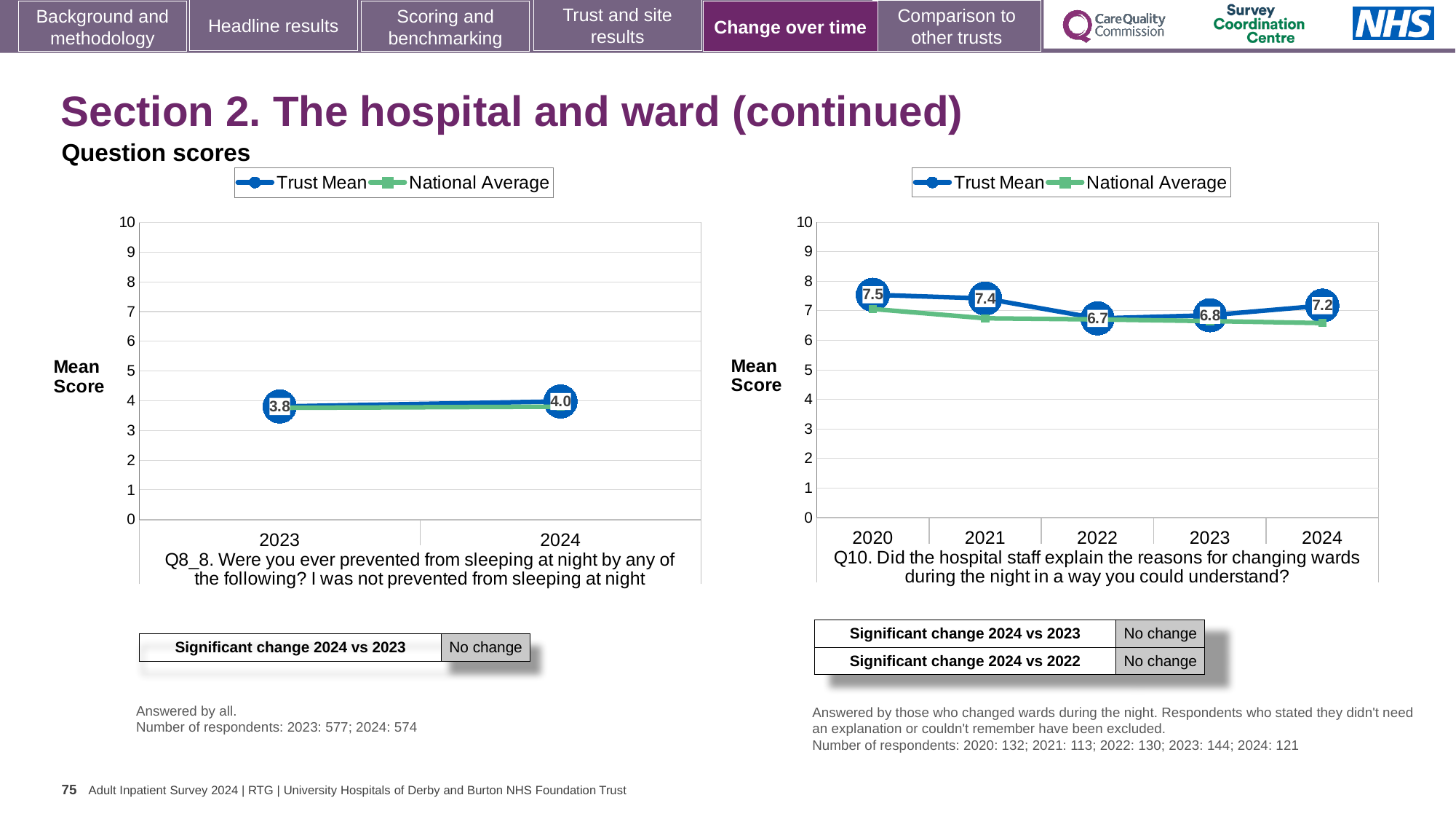
In the left chart (Q8_8), what is the Trust Mean score for 2024? 4.0 In the right chart (Q10), what is the Trust Mean score for 2024? 7.2 In the right chart (Q10), how many series does the legend list? 2 In the right chart (Q10), which year has the lowest Trust Mean score? 2022 In the right chart (Q10), which year has the highest Trust Mean score? 2020 In the left chart (Q8_8), how many years are plotted on the x axis? 2 What type of chart is the right chart (Q10)? Line chart In the left chart (Q8_8), what is the Trust Mean score for 2023? 3.8 In the right chart (Q10), what is the difference between the Trust Mean scores for 2020 and 2022? 0.8 In the left chart (Q8_8), is the Trust Mean for 2024 greater or less than 5? less In the right chart (Q10), what is the Trust Mean score for 2020? 7.5 In the right chart (Q10), what is the Trust Mean score for 2022? 6.7